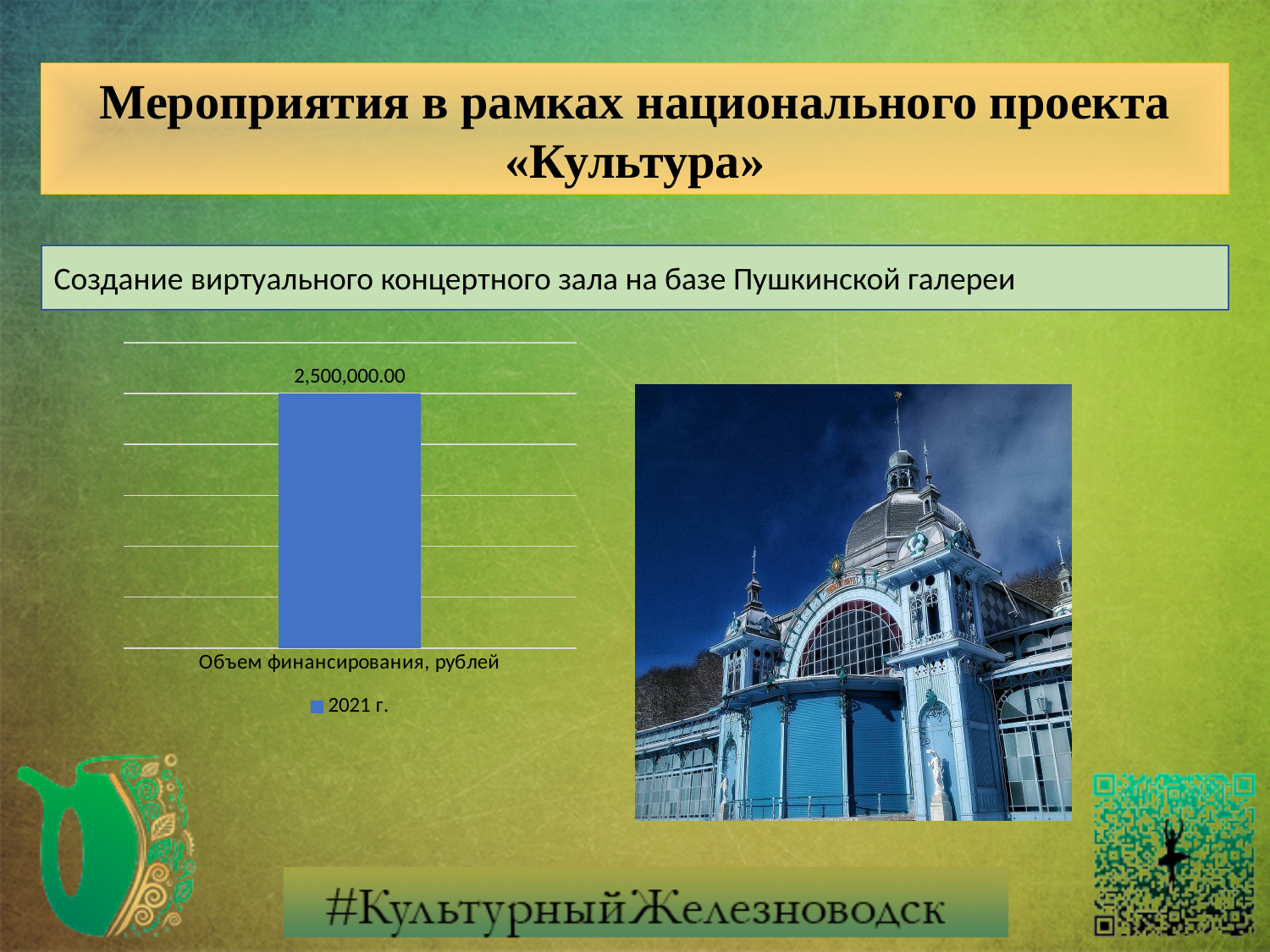
What series name appears in the chart legend? 2021 г. What is the category label shown under the bar? Объем финансирования, рублей How many series does the chart legend list? 1 What is the funding amount for 2021 г. shown in the chart? 2,500,000.00 How many bars are plotted in the chart? 1 What is the value of the bar labelled "Объем финансирования, рублей"? 2,500,000.00 What type of chart is shown on the slide? bar chart